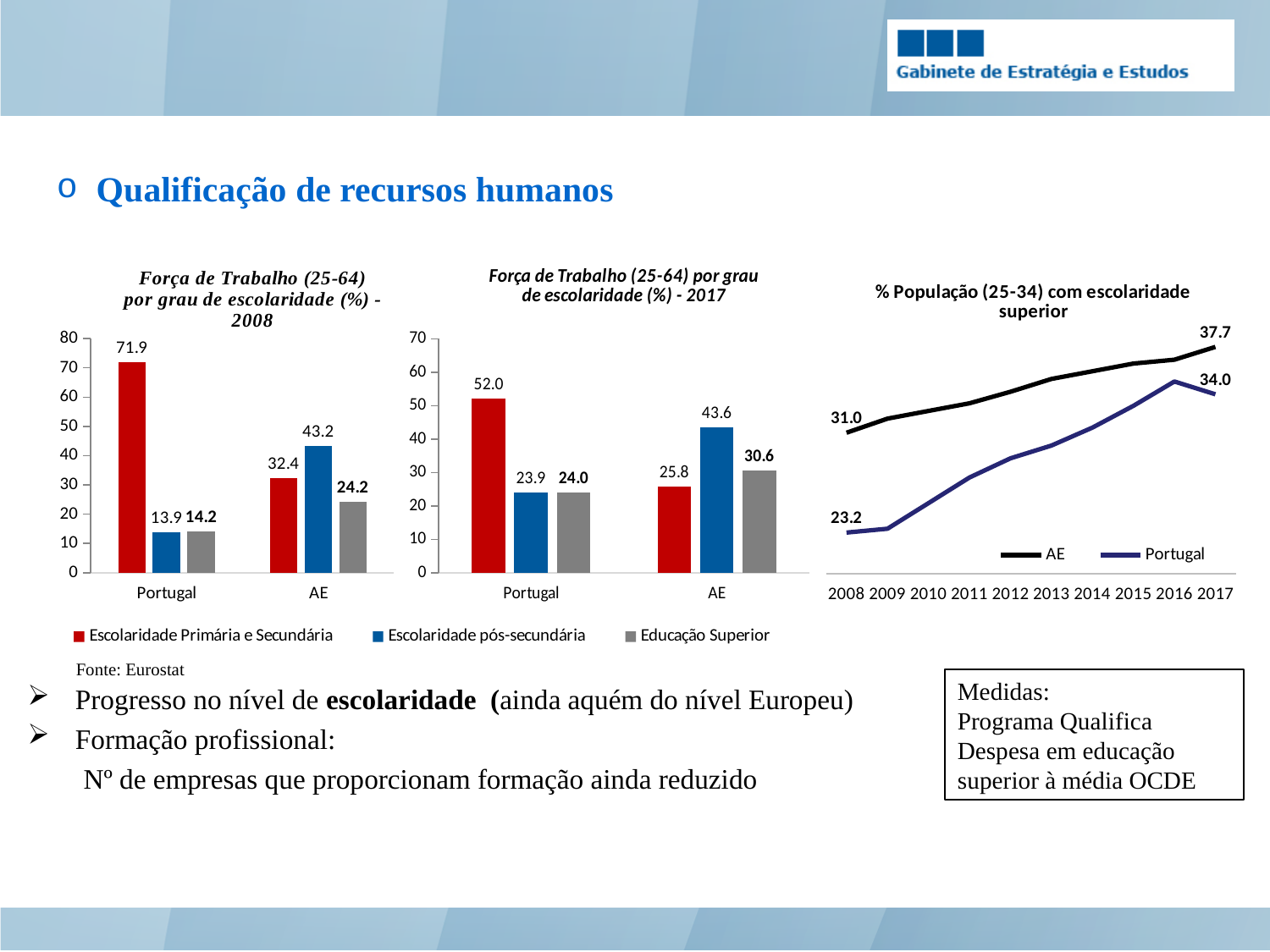
In the 2008 chart, which is larger: Escolaridade pós-secundária for AE or Escolaridade Primária e Secundária for AE? Escolaridade pós-secundária for AE In the chart '% População (25-34) com escolaridade superior', what is the value for Portugal in 2017? 34.0 In the chart '% População (25-34) com escolaridade superior', what is the value for AE in 2008? 31.0 In the 2008 chart, which series has the lowest value for Portugal? Escolaridade pós-secundária In the 2017 chart, which series has the highest value for Portugal? Escolaridade Primária e Secundária In the 2008 chart, what is the value for Educação Superior in AE? 24.2 In the 2017 chart, what is the difference between Escolaridade Primária e Secundária for Portugal and for AE? 26.2 In the 2017 chart, what is the value for Educação Superior in Portugal? 24.0 What kind of chart is '% População (25-34) com escolaridade superior'? line chart In the 2017 chart (Força de Trabalho (25-64) por grau de escolaridade (%) - 2017), what is the value for Escolaridade pós-secundária in AE? 43.6 In the chart '% População (25-34) com escolaridade superior', does the Portugal line rise or fall from 2008 to 2017? rise In the 2008 chart (Força de Trabalho (25-64) por grau de escolaridade (%) - 2008), what is the value for Escolaridade Primária e Secundária in Portugal? 71.9